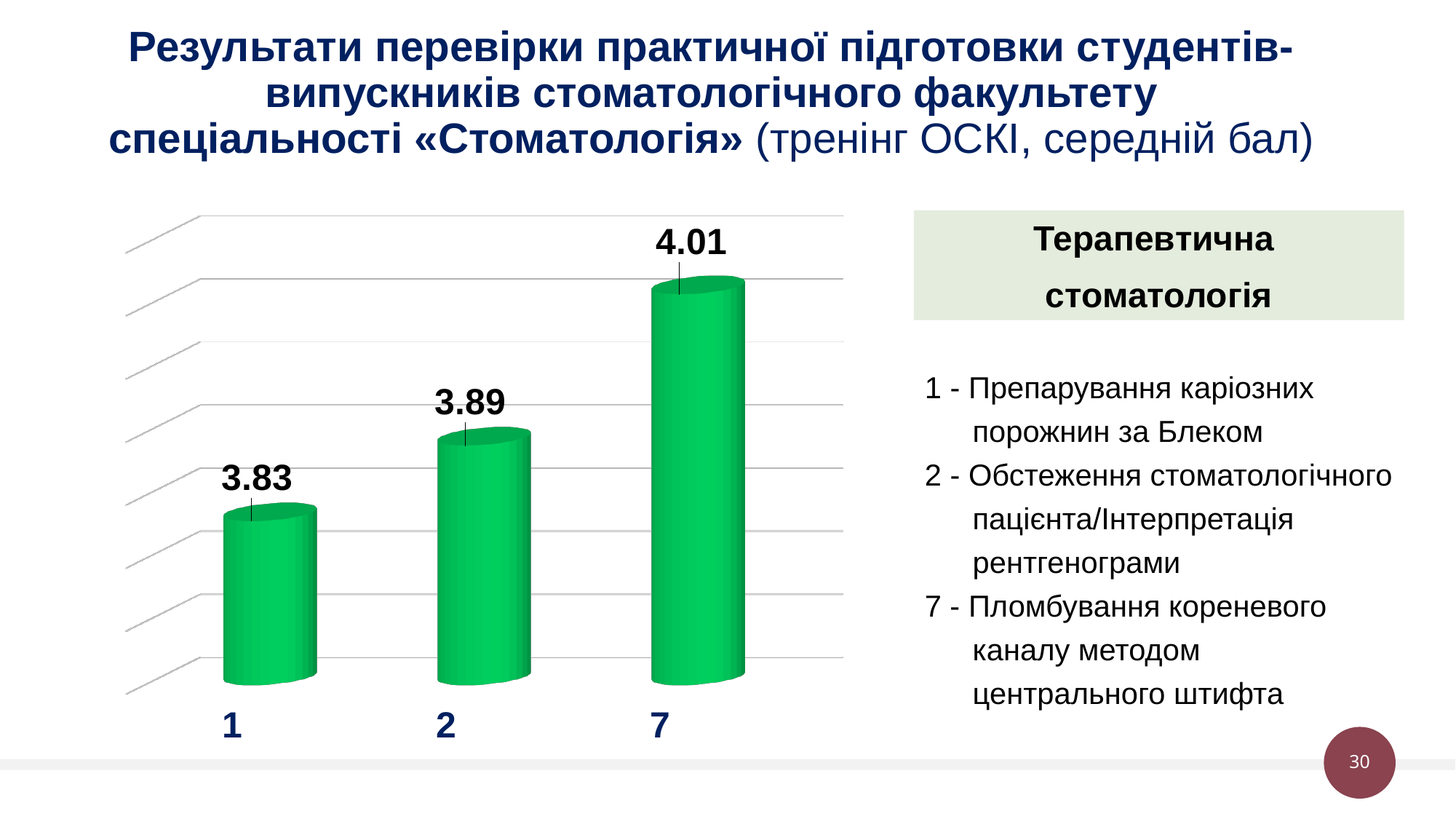
What is the value for category 2? 3.89 What colour are the bars in the chart? green What is the difference between the values for category 2 and category 1? 0.06 Which category has the lowest value? 1 How many bars are shown in the chart? 3 Do the values rise or fall from left to right along the x axis? rise What is the value for category 1? 3.83 Which is larger, the value for category 2 or the value for category 7? 7 Which category has the highest value? 7 What is the value for category 7? 4.01 What is the difference between the values for category 7 and category 1? 0.18 What kind of chart is shown on the slide? bar chart